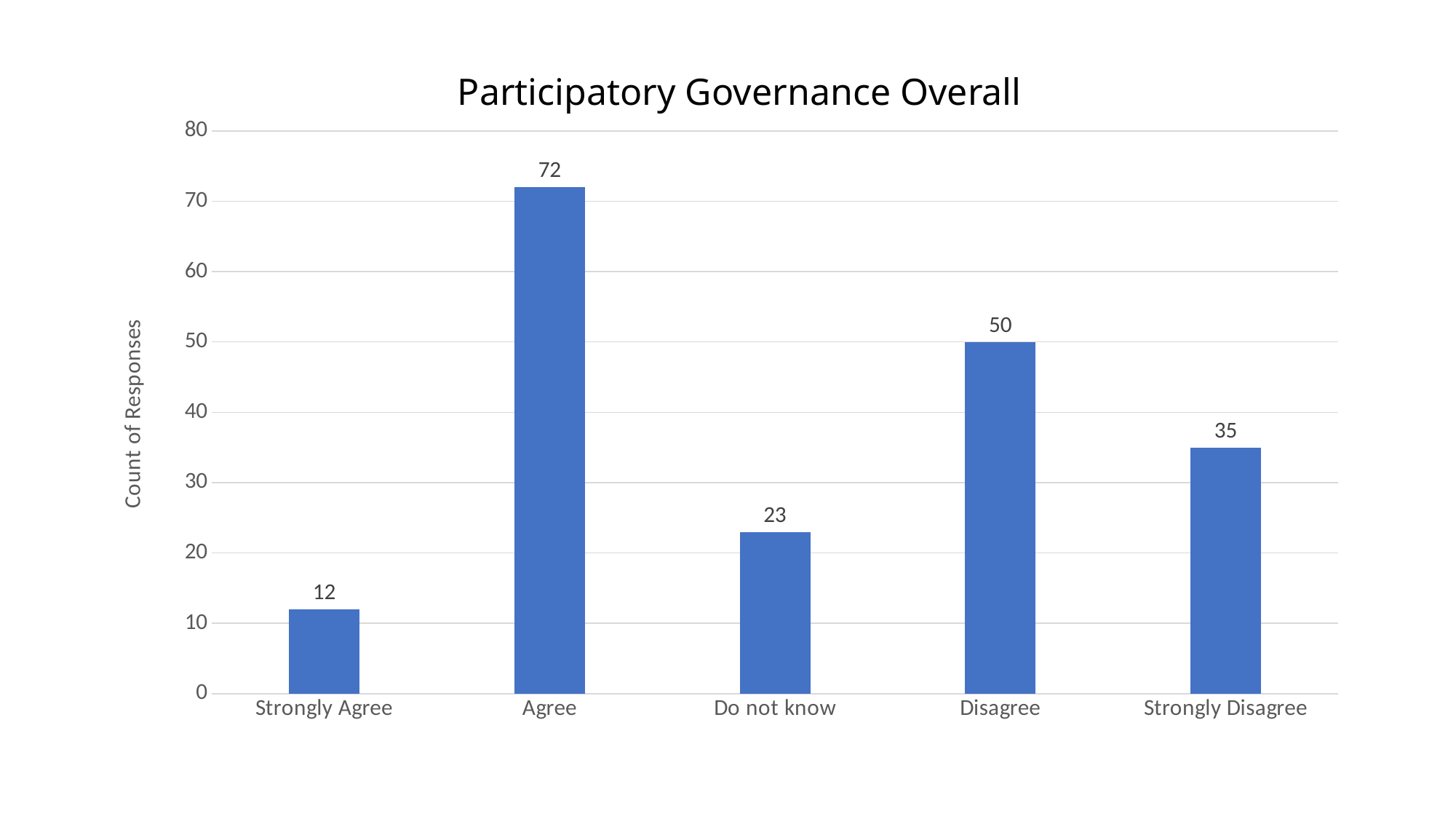
What is the title of the chart? Participatory Governance Overall Is the value for Disagree greater or less than 40? greater How many categories are shown on the x axis? 5 What is the count of responses for Agree? 72 Which category has the highest count of responses? Agree Which has a higher count of responses, Disagree or Do not know? Disagree What is the count of responses for Strongly Disagree? 35 What kind of chart is shown on the slide? bar chart What is the difference between the counts for Strongly Disagree and Strongly Agree? 23 What is the count of responses for Do not know? 23 What is the difference between the counts for Agree and Disagree? 22 Which category has the lowest count of responses? Strongly Agree